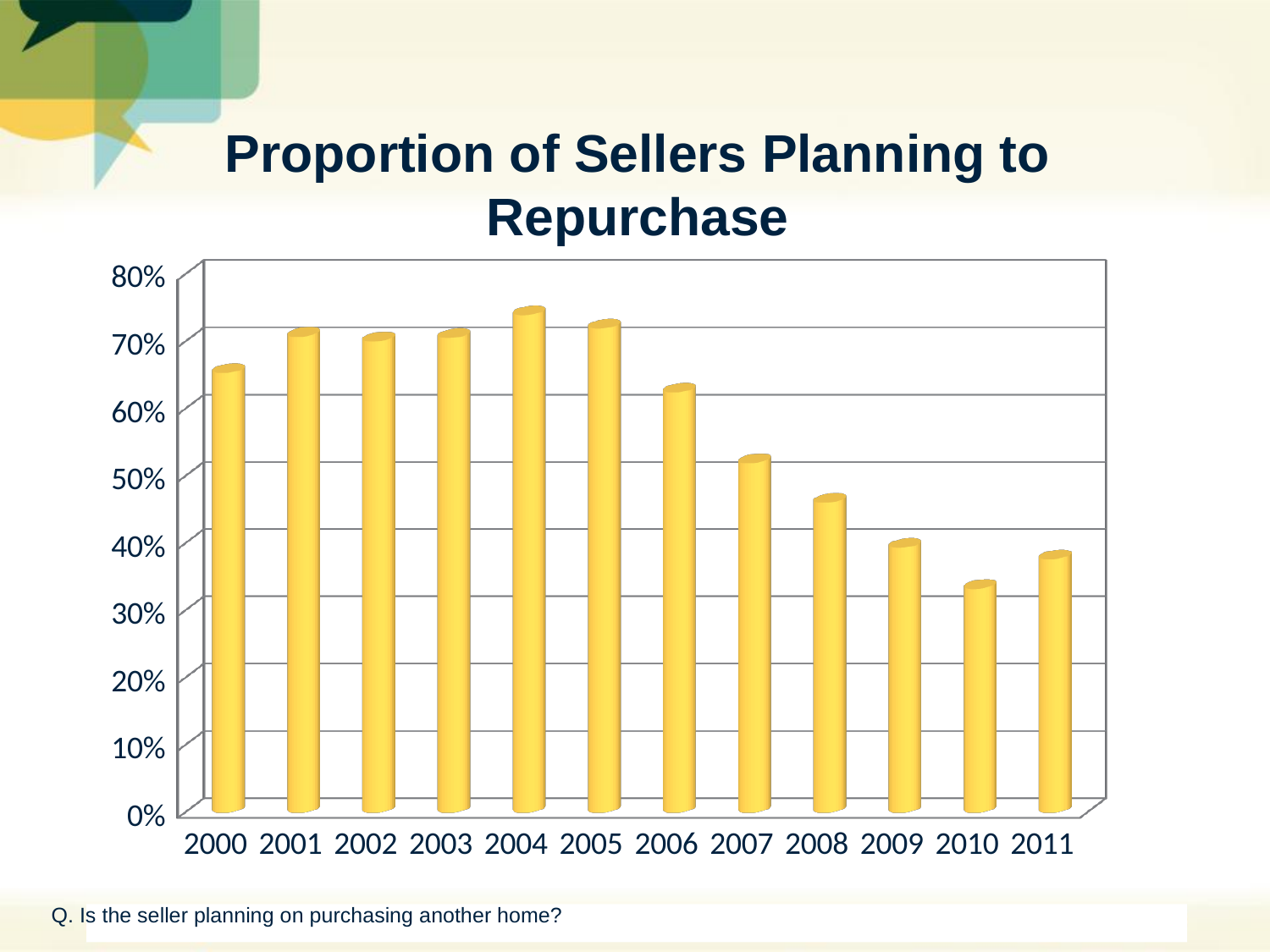
Do the values generally rise or fall from 2005 to 2010? fall Is the value for 2011 greater or less than 40%? less Which year has the larger value, 2001 or 2007? 2001 What kind of chart is shown on the slide? bar chart Is the value for 2010 greater or less than 30%? greater Which year has the highest proportion of sellers planning to repurchase? 2004 Is the value for 2004 greater or less than 70%? greater How many years are shown on the x axis of the chart? 12 Which year has the lowest proportion of sellers planning to repurchase? 2010 What is the title of the chart? Proportion of Sellers Planning to Repurchase